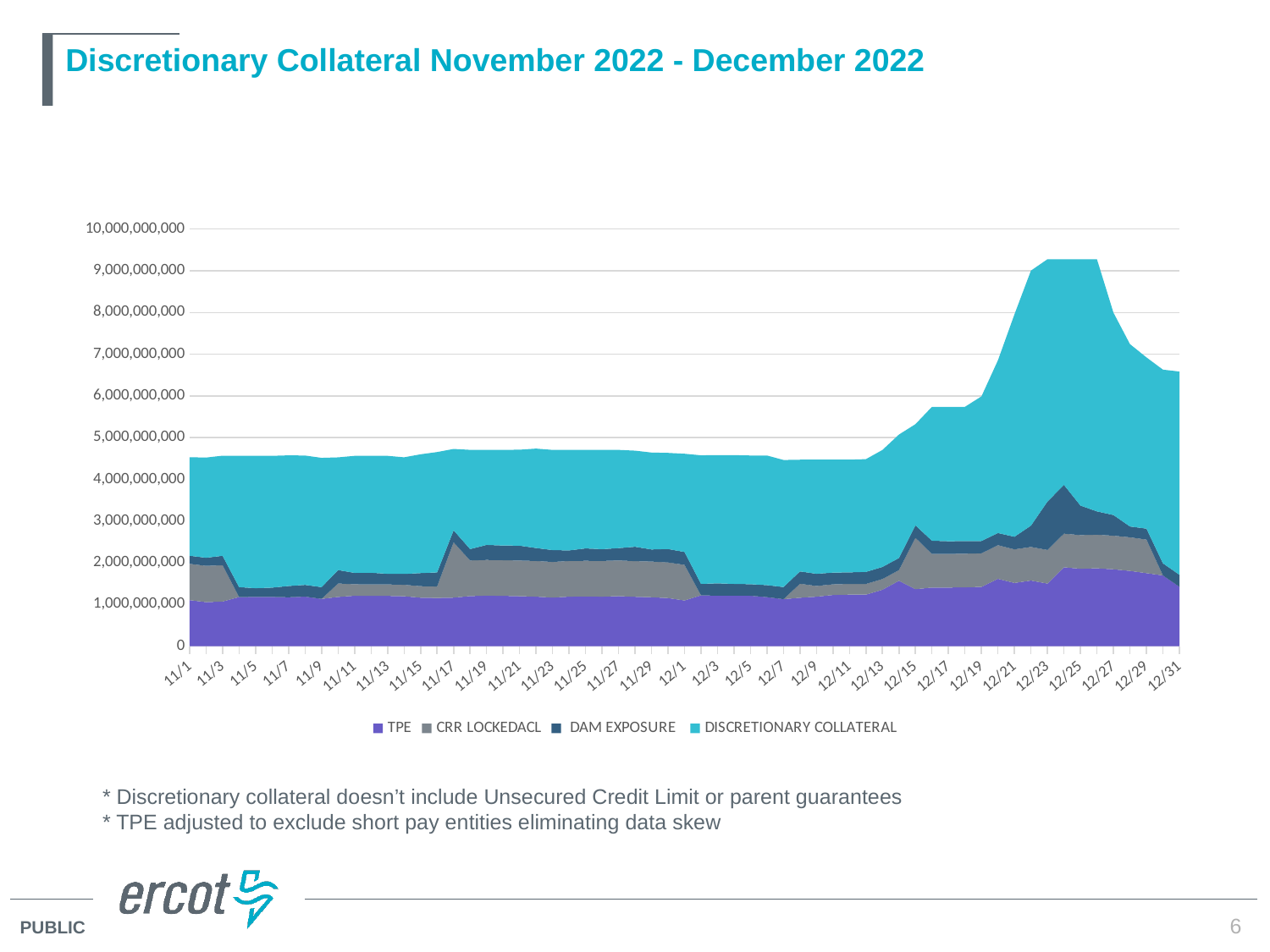
What kind of chart is shown on the slide? Stacked area chart Is the stacked total on 12/25 greater or less than 8,000,000,000? greater Is the stacked total on 12/31 greater or less than 6,000,000,000? greater How many series does the legend list? 4 Which series are listed in the legend? TPE, CRR LOCKEDACL, DAM EXPOSURE, DISCRETIONARY COLLATERAL Is the stacked total on 12/25 larger or smaller than the stacked total on 11/1? larger Does the stacked total rise or fall between 12/25 and 12/31? fall Is the stacked total on 11/1 greater or less than 5,000,000,000? less Does the stacked total reach its highest point in November or in December? December Does the stacked total rise or fall between 12/13 and 12/23? rise What is the title of the chart? Discretionary Collateral November 2022 - December 2022